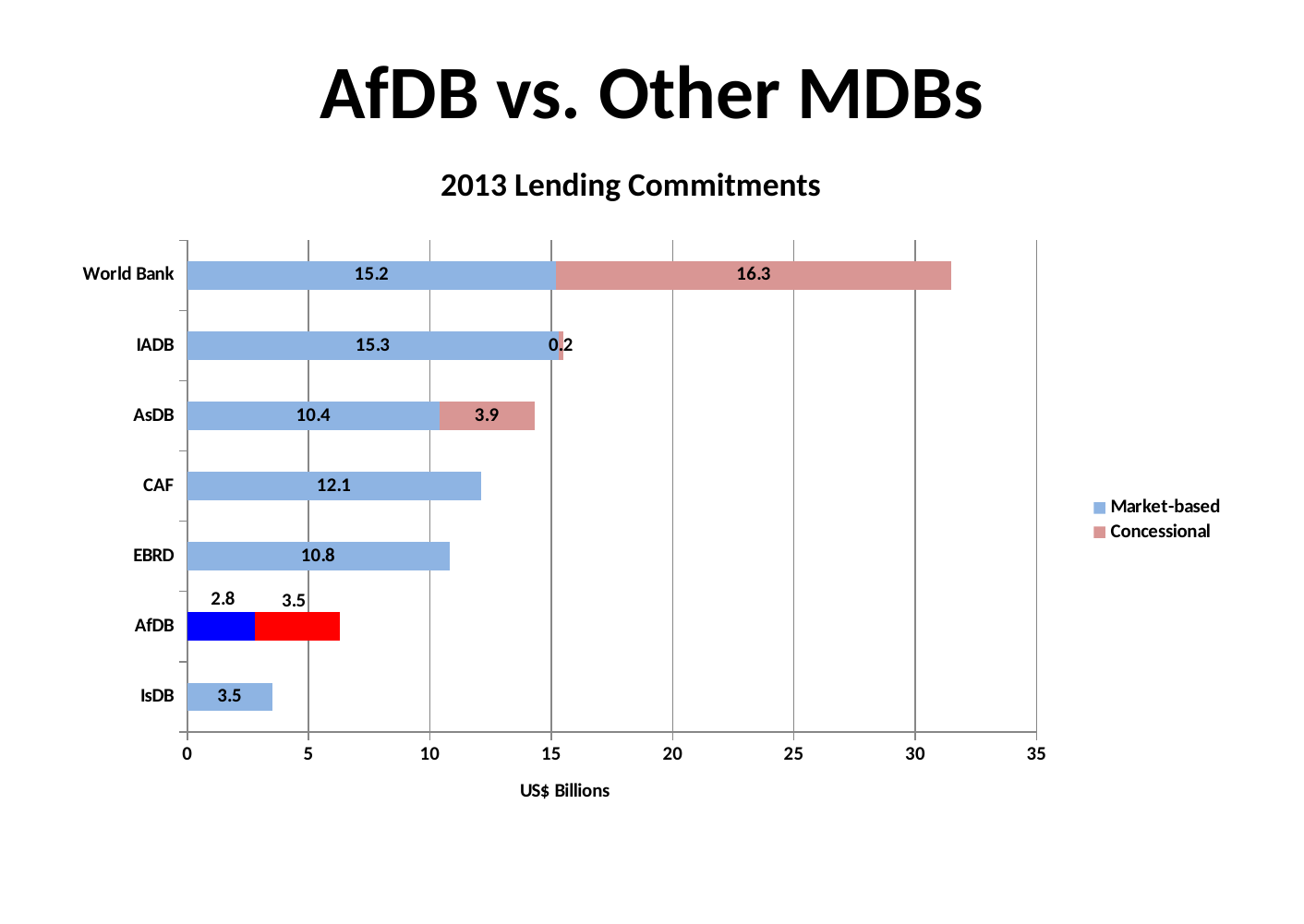
What is the Market-based lending commitment for the World Bank? 15.2 Which institution has the lowest Market-based lending commitment? AfDB How many series does the legend list? 2 What is the total lending commitment for AfDB (Market-based plus Concessional)? 6.3 What is the Market-based lending commitment for IsDB? 3.5 Which is larger, the Concessional commitment of the World Bank or of AsDB? World Bank What is the difference between the Market-based commitments of CAF and EBRD? 1.3 What is the Concessional lending commitment for AfDB? 3.5 What is the total lending commitment for the World Bank (Market-based plus Concessional)? 31.5 What is the Concessional lending commitment for AsDB? 3.9 Which institution has the highest Market-based lending commitment? IADB How many institutions are shown on the chart? 7